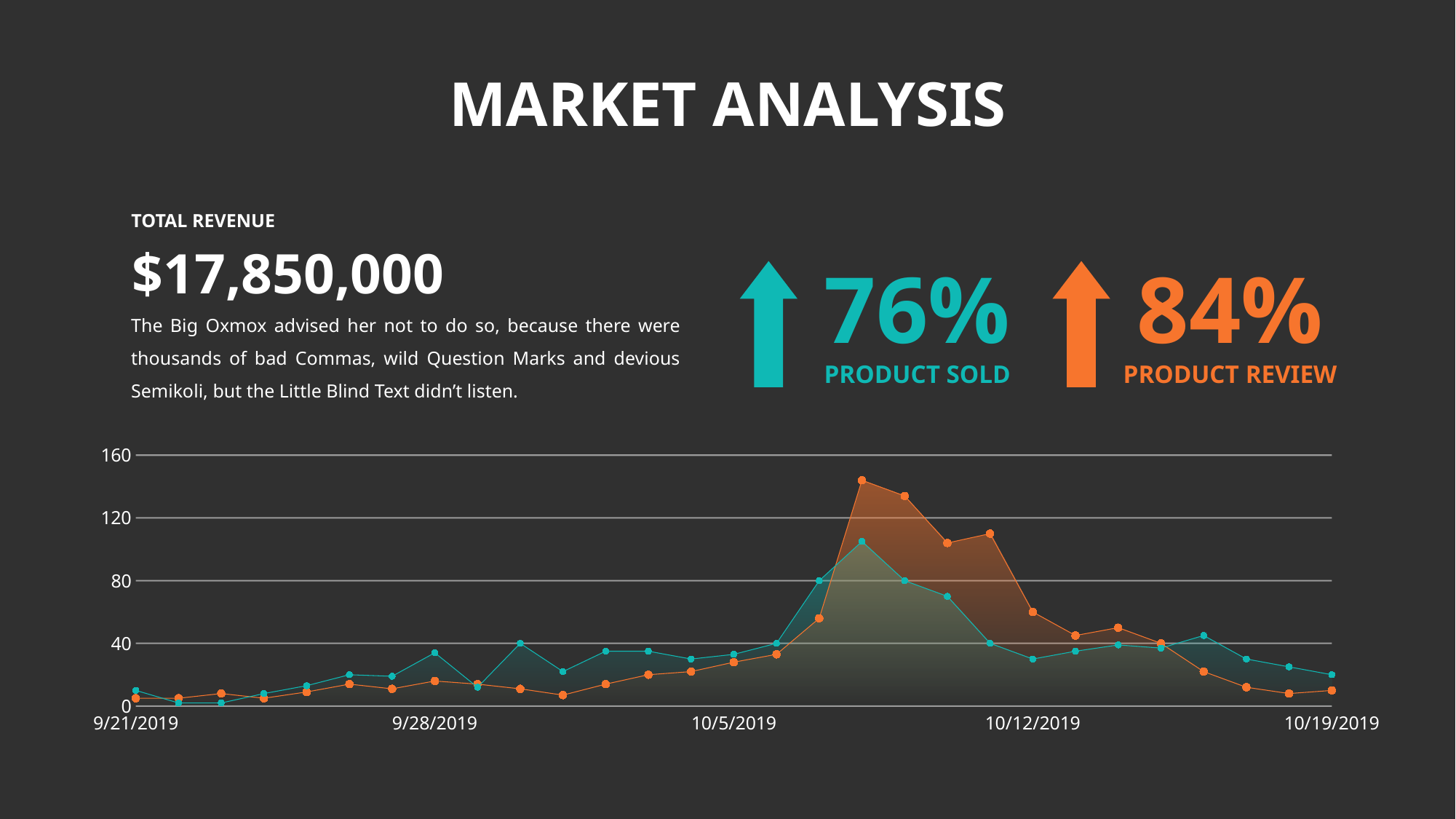
Which series reaches the highest value anywhere on the chart, the orange or the teal? orange What kind of chart is shown at the bottom of the slide? line chart with shaded area fills (combination area and line chart) Is the value of the orange series at 10/12/2019 greater or less than 80? less At 10/12/2019, which series has the larger value, the orange or the teal? orange How many data series are plotted in the chart? 2 Is the value of the teal series at 10/5/2019 greater or less than 40? less At 9/28/2019, which series has the larger value, the orange or the teal? teal How many date labels are shown on the x axis of the chart? 5 What is the highest value shown on the chart's y axis? 160 Is the peak value of the teal series greater or less than 80? greater